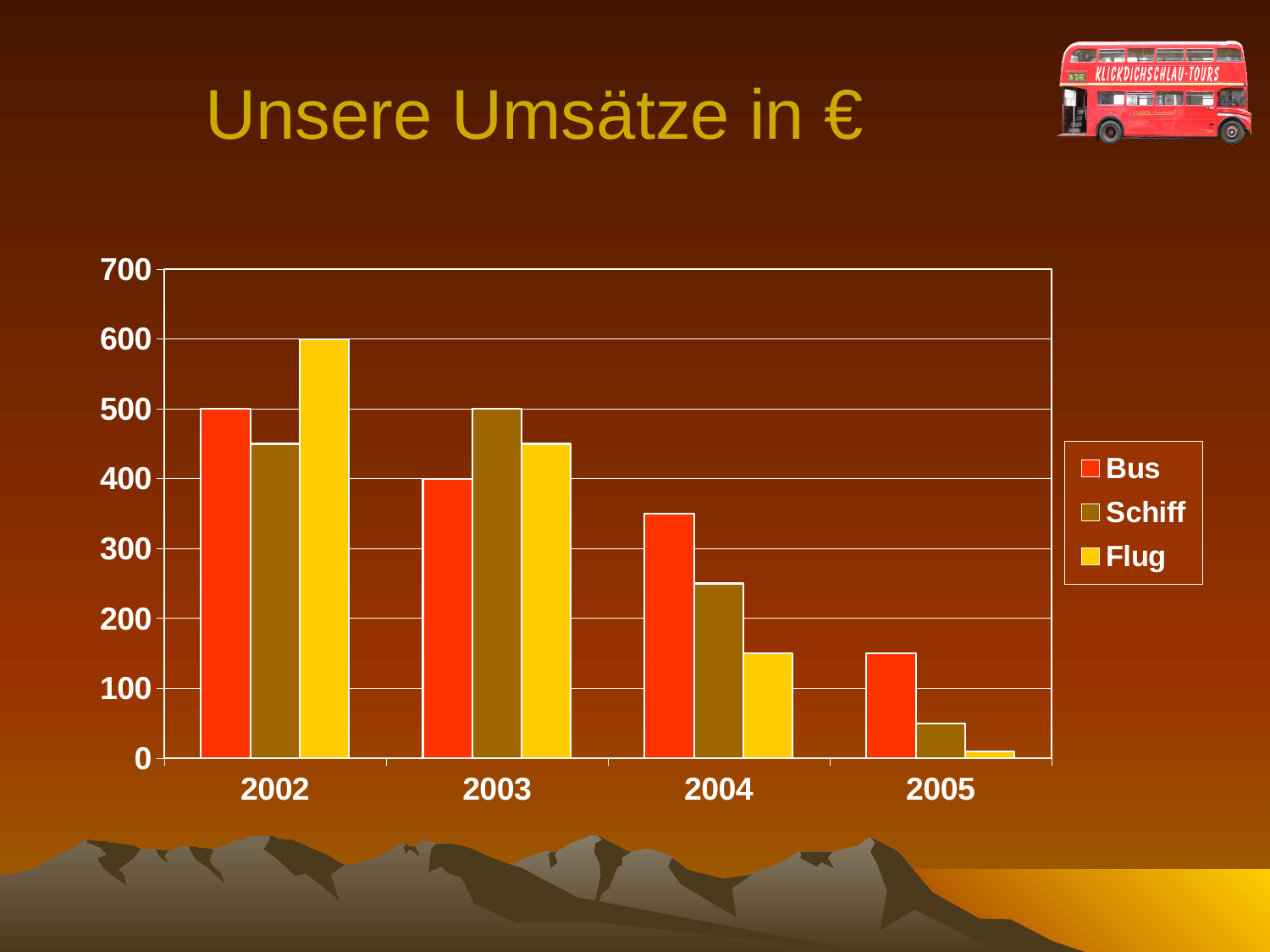
Do the Bus values rise or fall from 2002 to 2005? fall How many years are shown on the x axis? 4 What is the value for Bus in 2003? 400 How many series does the legend list? 3 What kind of chart is shown on the slide? bar chart Which series has the lowest value in 2005? Flug Which series has the highest value in 2002? Flug What is the value for Schiff in 2003? 500 Is the value for Flug in 2004 greater or less than 200? less Is the value for Bus in 2004 greater or less than 300? greater What is the value for Bus in 2002? 500 What is the value for Flug in 2002? 600